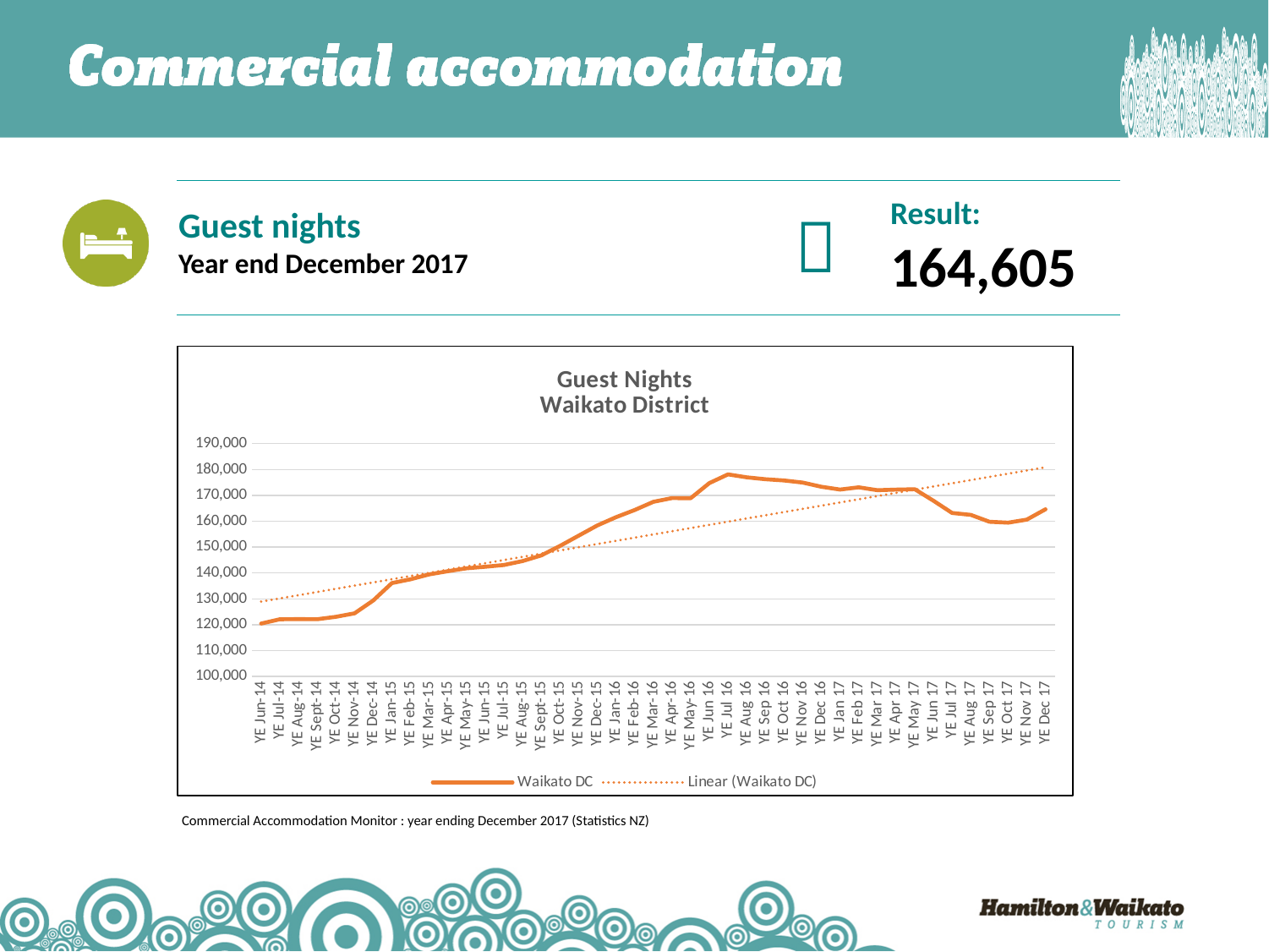
Which is larger, the Waikato DC value for YE Jul 16 or for YE Dec 17? YE Jul 16 At which period does the Waikato DC line reach its highest value? YE Jul 16 Is the Waikato DC value for YE Jun-14 greater or less than 130,000? less What kind of chart is shown on the slide? line chart How many series does the chart legend list? 2 What is the guest nights value for YE Dec 17, as stated in the Result on the slide? 164,605 What are the two entries in the chart legend? Waikato DC and Linear (Waikato DC) At which period is the Waikato DC line at its lowest value? YE Jun-14 Is the Waikato DC value for YE Mar-16 greater or less than 160,000? greater Is the Waikato DC value for YE Jul 16 greater or less than 170,000? greater How many periods are shown along the x axis of the chart? 43 What is the title of the chart? Guest Nights Waikato District